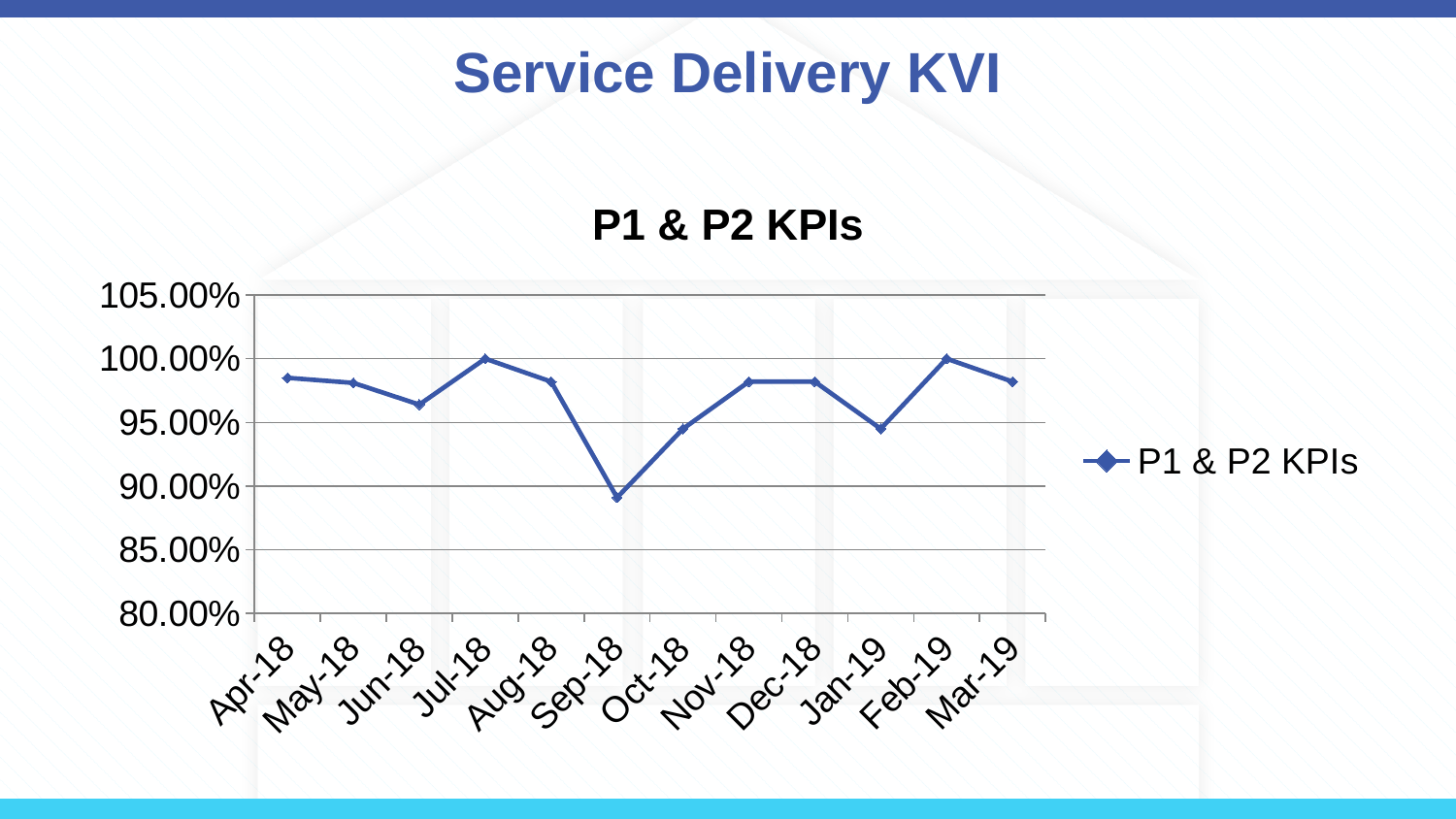
Is the value for Apr-18 greater or less than 95.00%? greater How many series does the chart's legend list? 1 Do the values rise or fall from Aug-18 to Sep-18? fall Which is larger, the value for Jun-18 or the value for Jul-18? Jul-18 Is the value for Sep-18 greater or less than 90.00%? less What is the title of the chart? P1 & P2 KPIs Which is larger, the value for Sep-18 or the value for Oct-18? Oct-18 How many months are plotted on the x axis of the chart? 12 What kind of chart is shown on the slide? line chart Which month has the lowest value in the chart? Sep-18